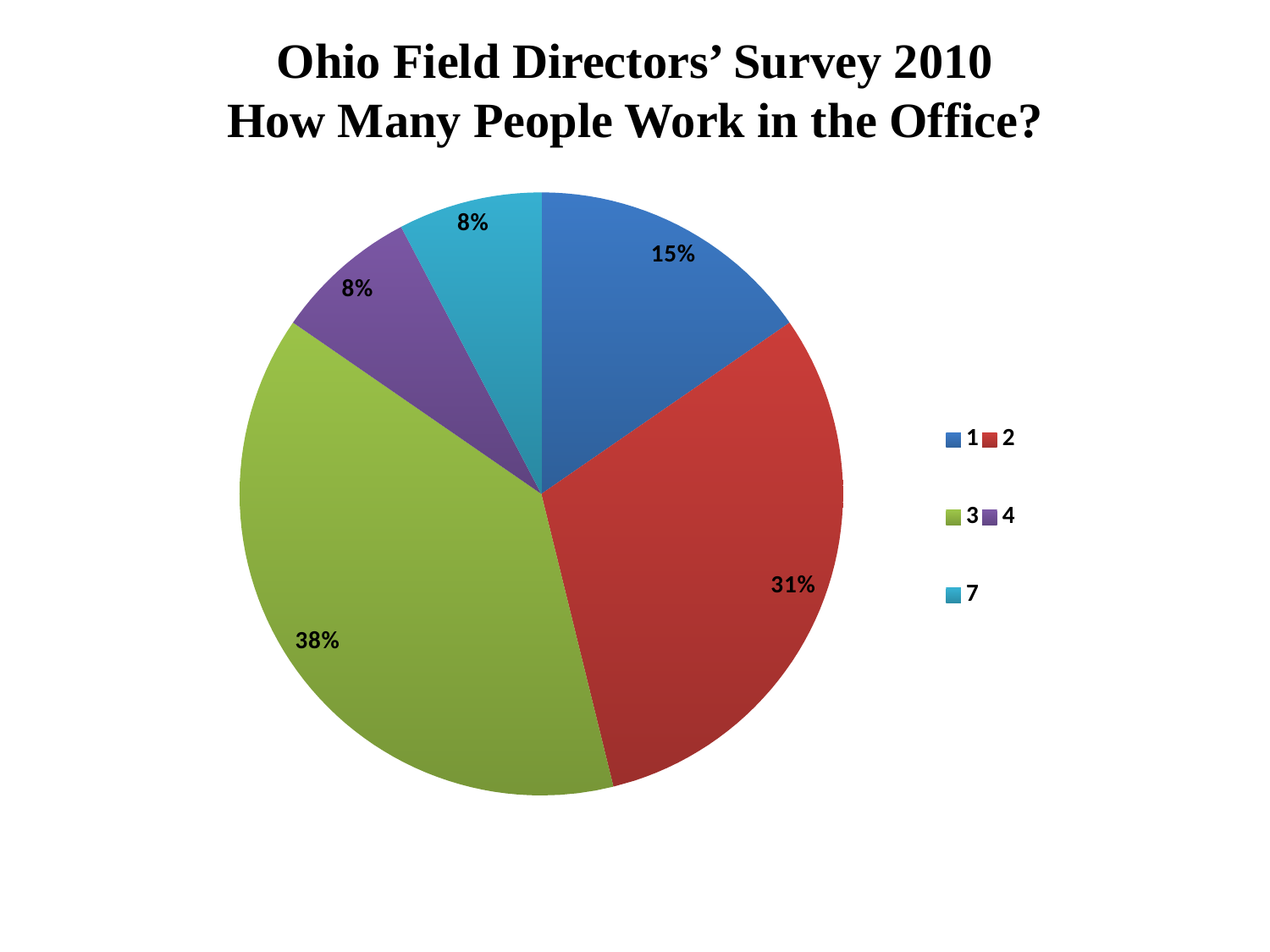
Which category has the largest slice of the pie? 3 What kind of chart is shown on the slide? pie chart What share of the pie does the category "2" have? 31% How many slices does the pie chart have? 5 What is the title of the chart? Ohio Field Directors' Survey 2010 How Many People Work in the Office? What is the difference in percentage points between the slices for "2" and "1"? 16 Which slice is larger, the one for "1" or the one for "4"? 1 What share of the pie does the category "3" have? 38% What is the difference in percentage points between the slices for "3" and "2"? 7 What colour is the slice for category "3"? green What share of the pie does the category "7" have? 8%